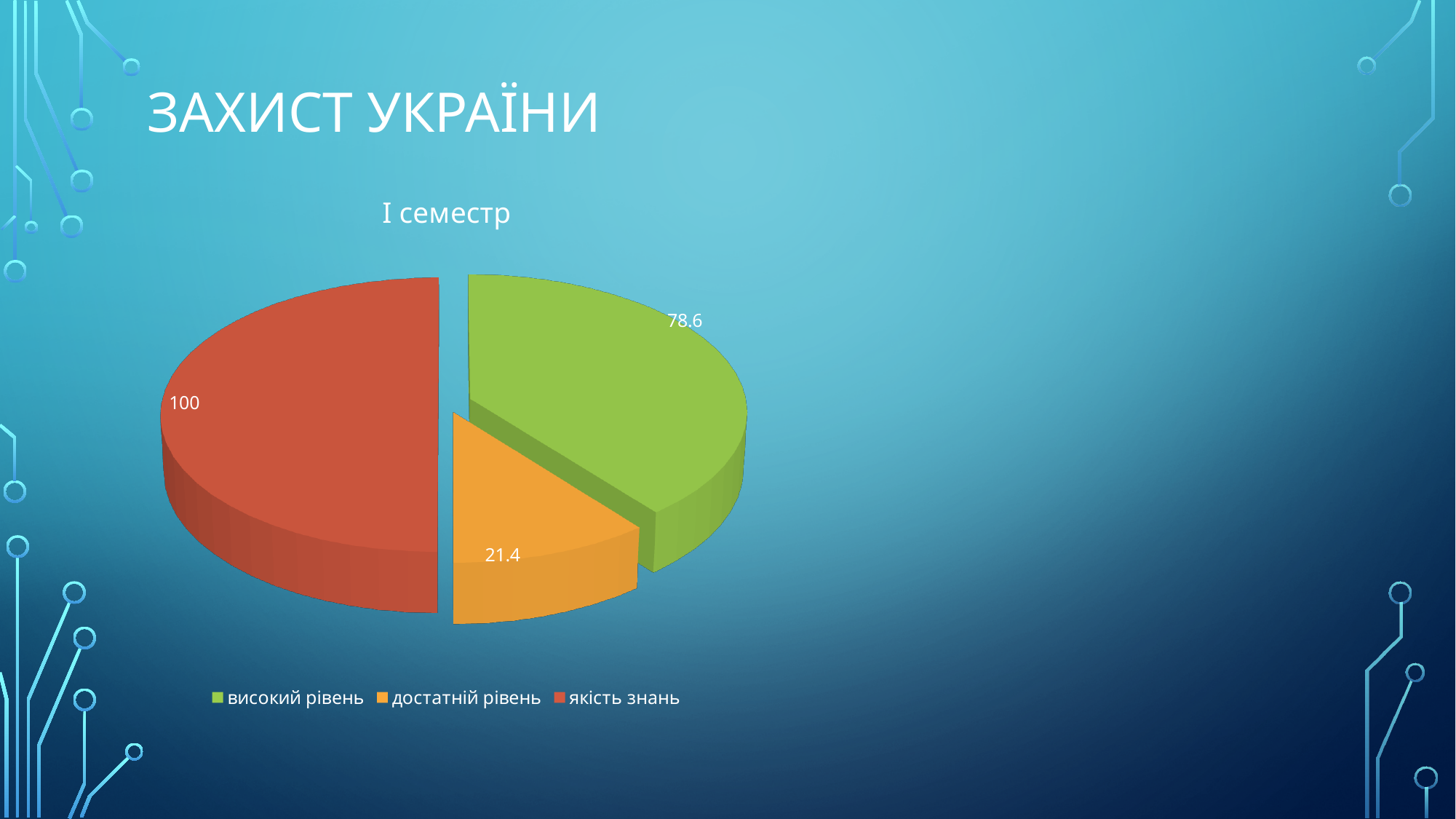
What is the value for достатній рівень? 21.4 What is the value for високий рівень? 78.6 How many entries does the legend list? 3 What is the value for якість знань? 100 Which is larger, the value for високий рівень or the value for достатній рівень? високий рівень What kind of chart is shown on the slide? pie chart How many slices does the pie chart have? 3 What is the difference between the values for високий рівень and достатній рівень? 57.2 Which category has the largest slice? якість знань Which category has the smallest slice? достатній рівень What is the title of the chart? І семестр What colour is the slice for достатній рівень? orange